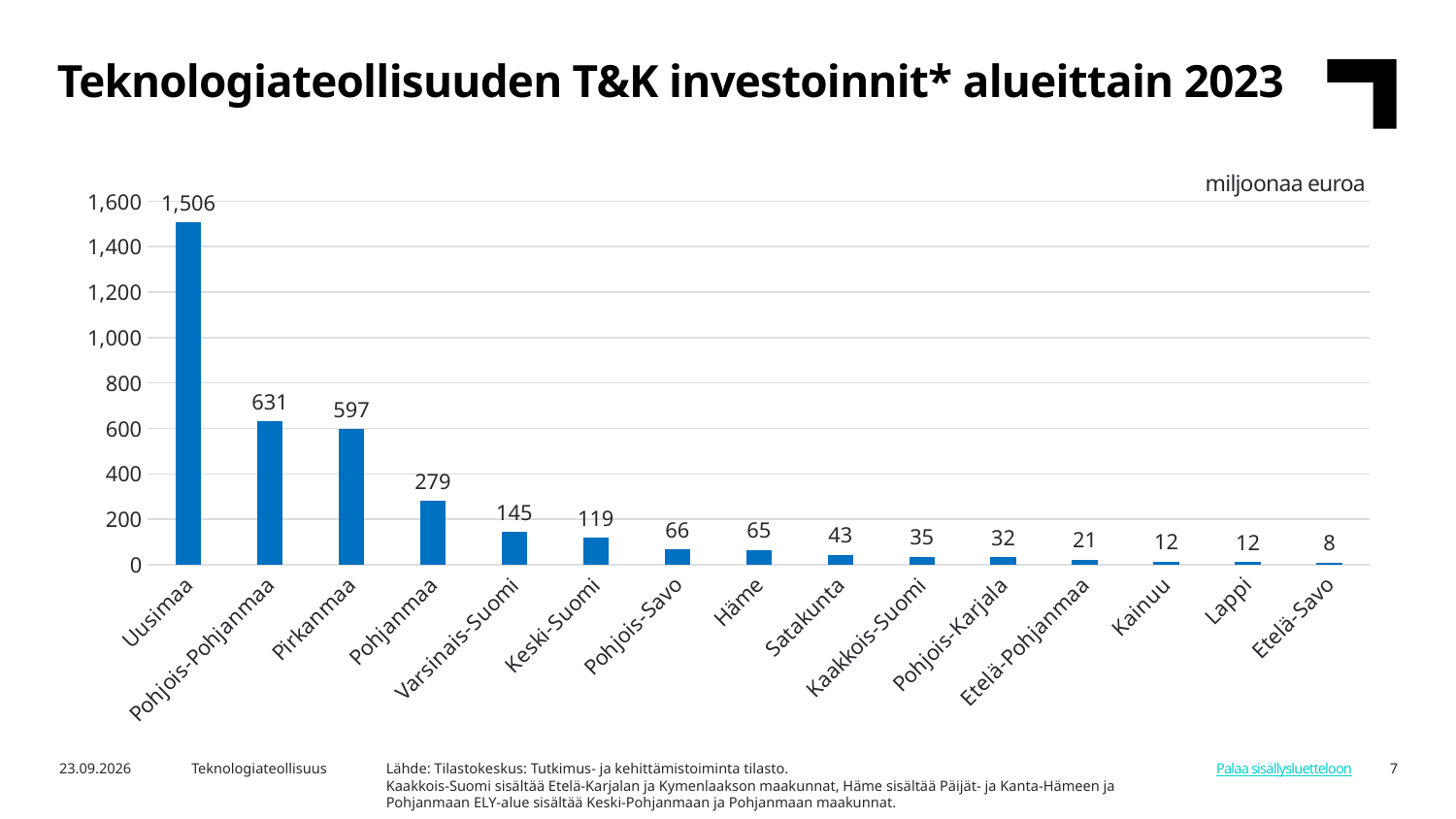
What unit is the chart measured in, as shown above the plot area? miljoonaa euroa What is the value for Etelä-Pohjanmaa? 21 Which region has the lowest value? Etelä-Savo What is the difference between the values for Uusimaa and Pohjois-Pohjanmaa? 875 Is the value for Pohjanmaa greater or less than 200? greater What is the value for Varsinais-Suomi? 145 What is the value for Uusimaa? 1,506 What is the value for Pirkanmaa? 597 What is the difference between the values for Pohjois-Pohjanmaa and Pirkanmaa? 34 Which region has the highest value? Uusimaa Which is larger, the value for Keski-Suomi or the value for Pohjois-Savo? Keski-Suomi How many regions are shown in the chart? 15